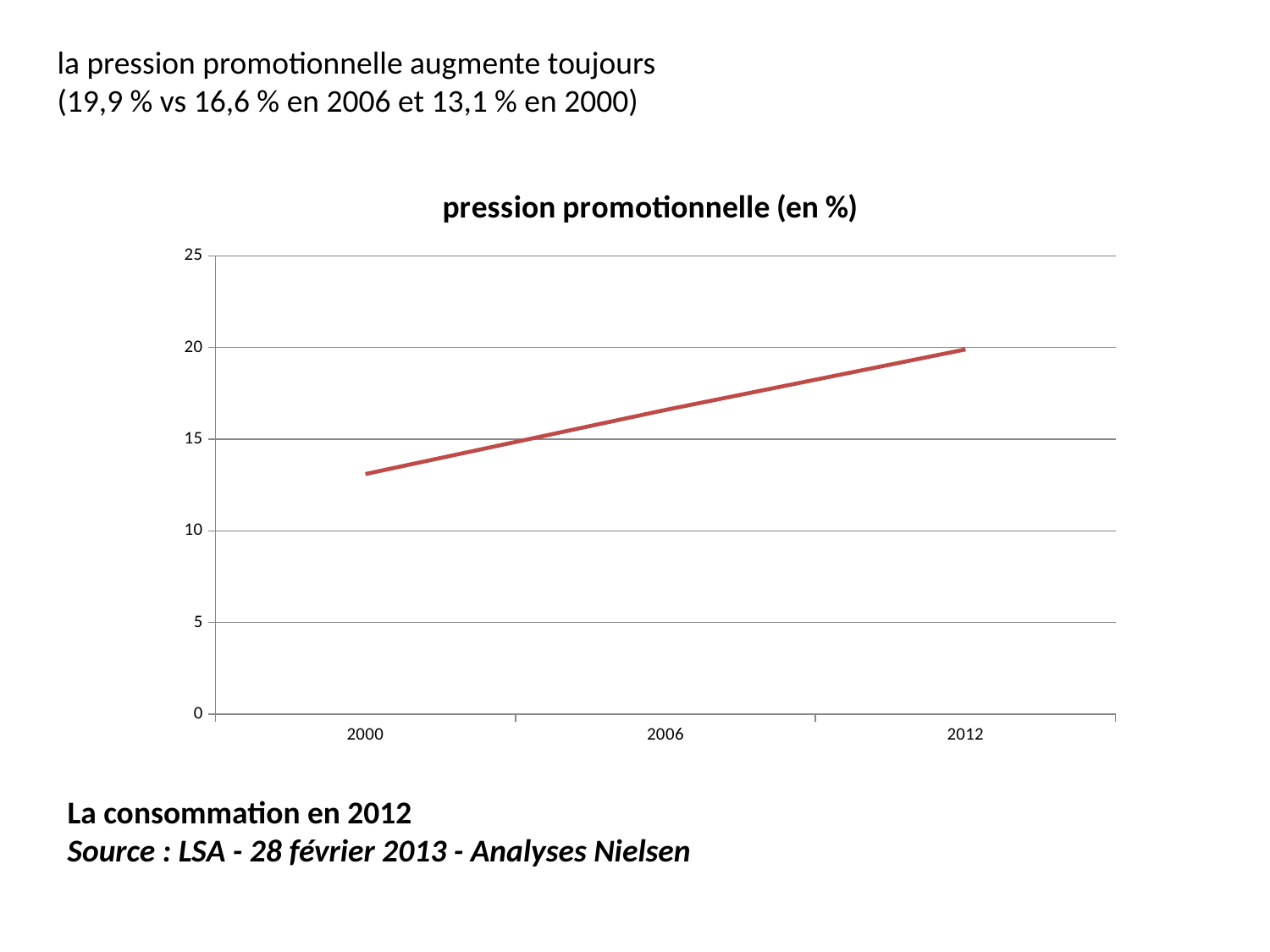
According to the slide text, what was the promotional pressure in 2006? 16,6 % Which year has the highest promotional pressure? 2012 According to the slide text, what was the promotional pressure in 2000? 13,1 % How many years are plotted on the x axis of the chart? 3 What type of chart is shown on the slide? line chart Which year has the lowest promotional pressure? 2000 Is the value for 2006 greater or less than 20? less What is the title of the chart? pression promotionnelle (en %) Which is larger, the value for 2006 or the value for 2012? 2012 Does the promotional pressure rise or fall from 2000 to 2012? rise Is the value for 2000 greater or less than 15? less Is the value for 2012 greater or less than 15? greater